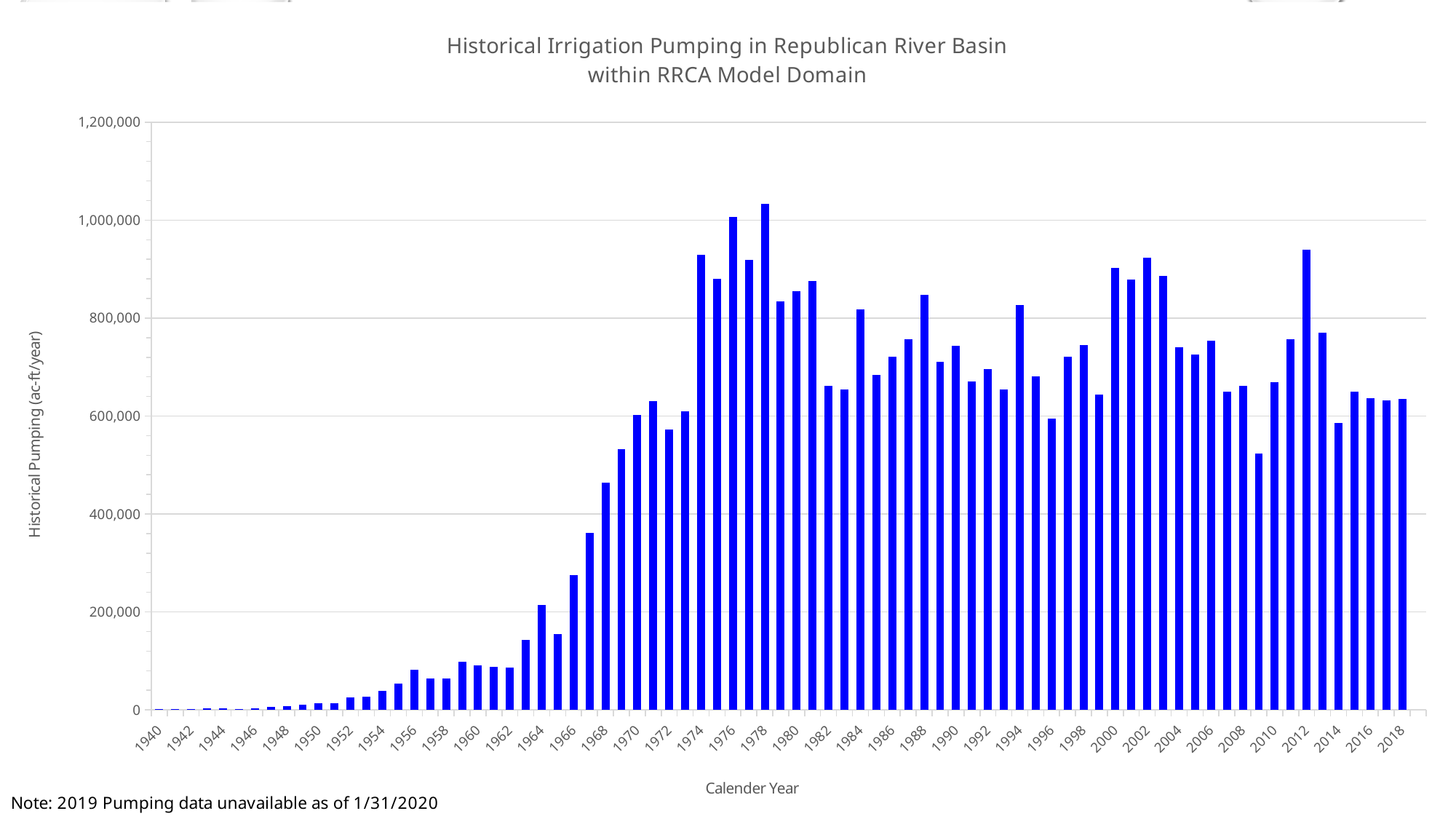
Which year has the larger pumping value, 1966 or 1968? 1968 Which year has the highest historical irrigation pumping? 1978 Which year has the larger pumping value, 2000 or 2010? 2000 What kind of chart is shown on the slide? bar chart Is the value for 1968 greater or less than 400,000? greater What is the label of the y axis? Historical Pumping (ac-ft/year) Is the value for 2010 greater or less than 600,000? greater Is the value for 2012 greater or less than 800,000? greater Do the pumping values generally rise or fall from 1940 to 1978? rise